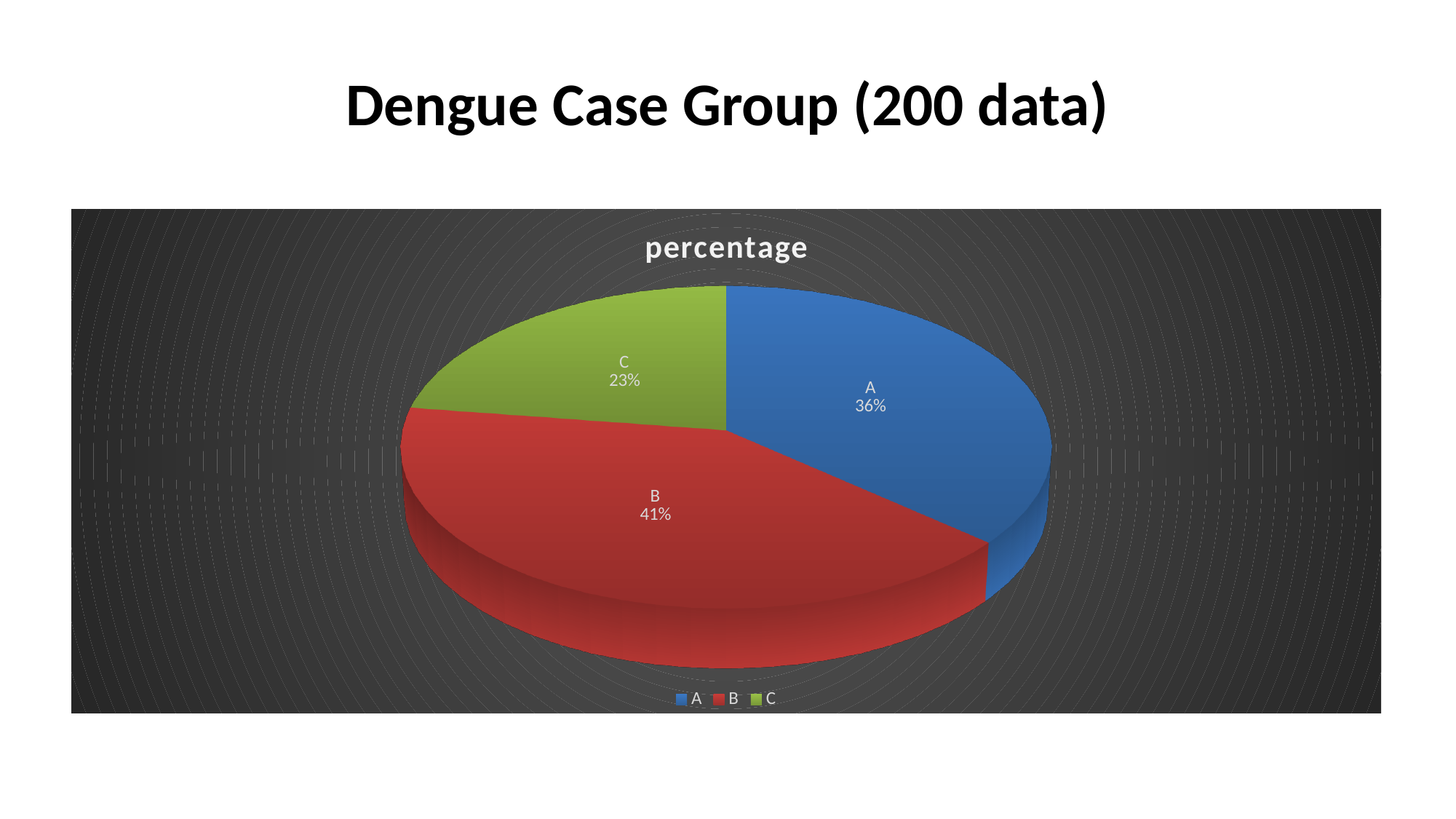
What percentage does slice A represent in the pie chart? 36% How many slices does the pie chart have? 3 Which is larger, the share for A or the share for C? A What is the title of the chart? percentage What percentage does slice B represent in the pie chart? 41% What kind of chart is shown on the slide? pie chart What is the difference in percentage points between group B and group A? 5 What is the difference in percentage points between group B and group C? 18 Which group has the smallest share of the pie? C Which group has the largest share of the pie? B What percentage does slice C represent in the pie chart? 23% What colour is the slice for group B? red